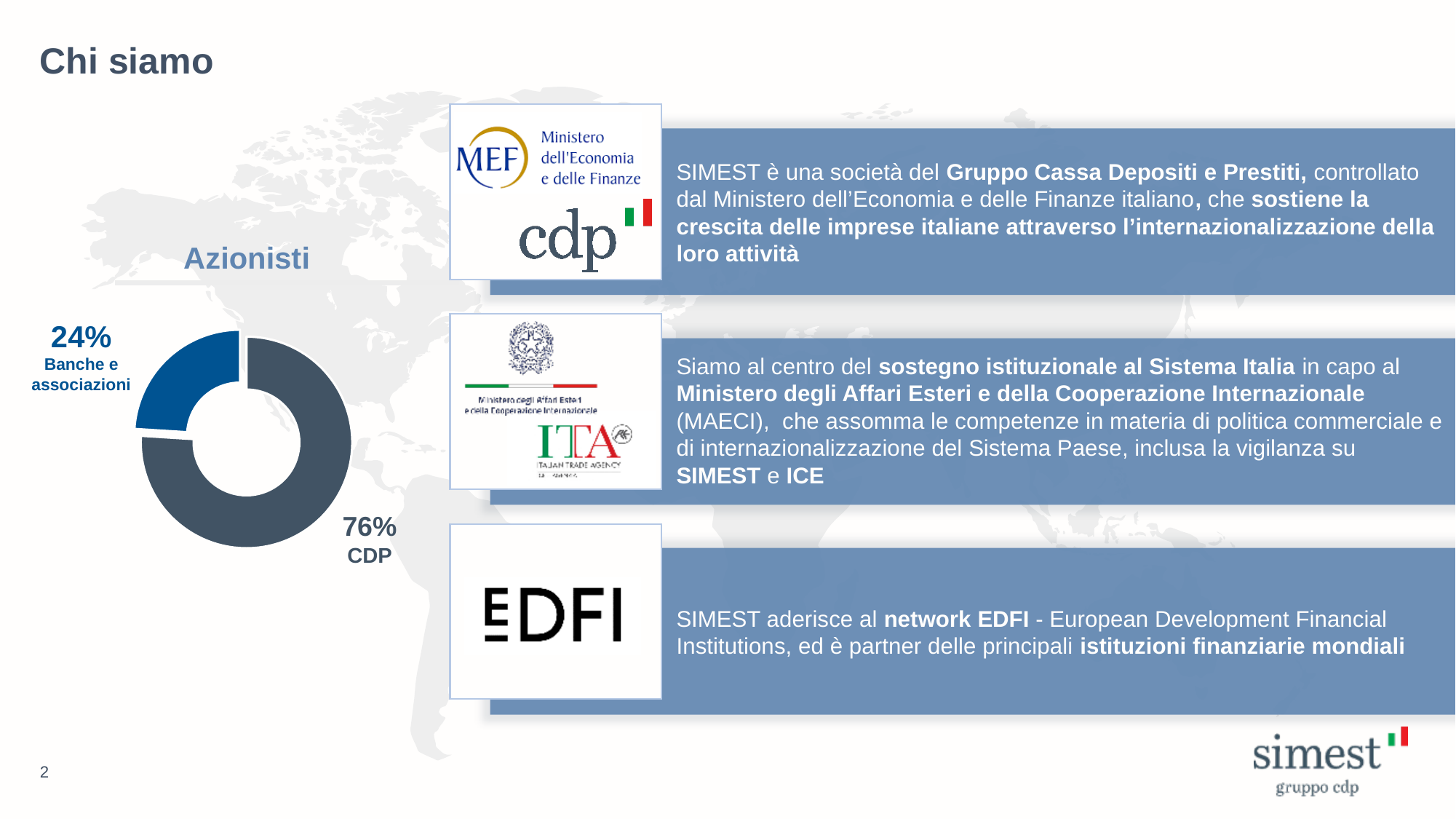
What share of the Azionisti chart does CDP hold? 76% Which shareholder category has the smallest share in the Azionisti chart? Banche e associazioni What is the title of the chart on the left of the slide? Azionisti What is the total of the two shares shown in the Azionisti chart? 100% Which is larger: the share of CDP or the share of Banche e associazioni? CDP What kind of chart is used to show the Azionisti breakdown? Doughnut chart What is the difference in percentage points between the CDP share and the Banche e associazioni share? 52 Which shareholder category has the largest share in the Azionisti chart? CDP How many categories are shown in the Azionisti chart? 2 What share of the Azionisti chart do Banche e associazioni hold? 24% Which category is shown in the lighter blue segment of the Azionisti chart? Banche e associazioni